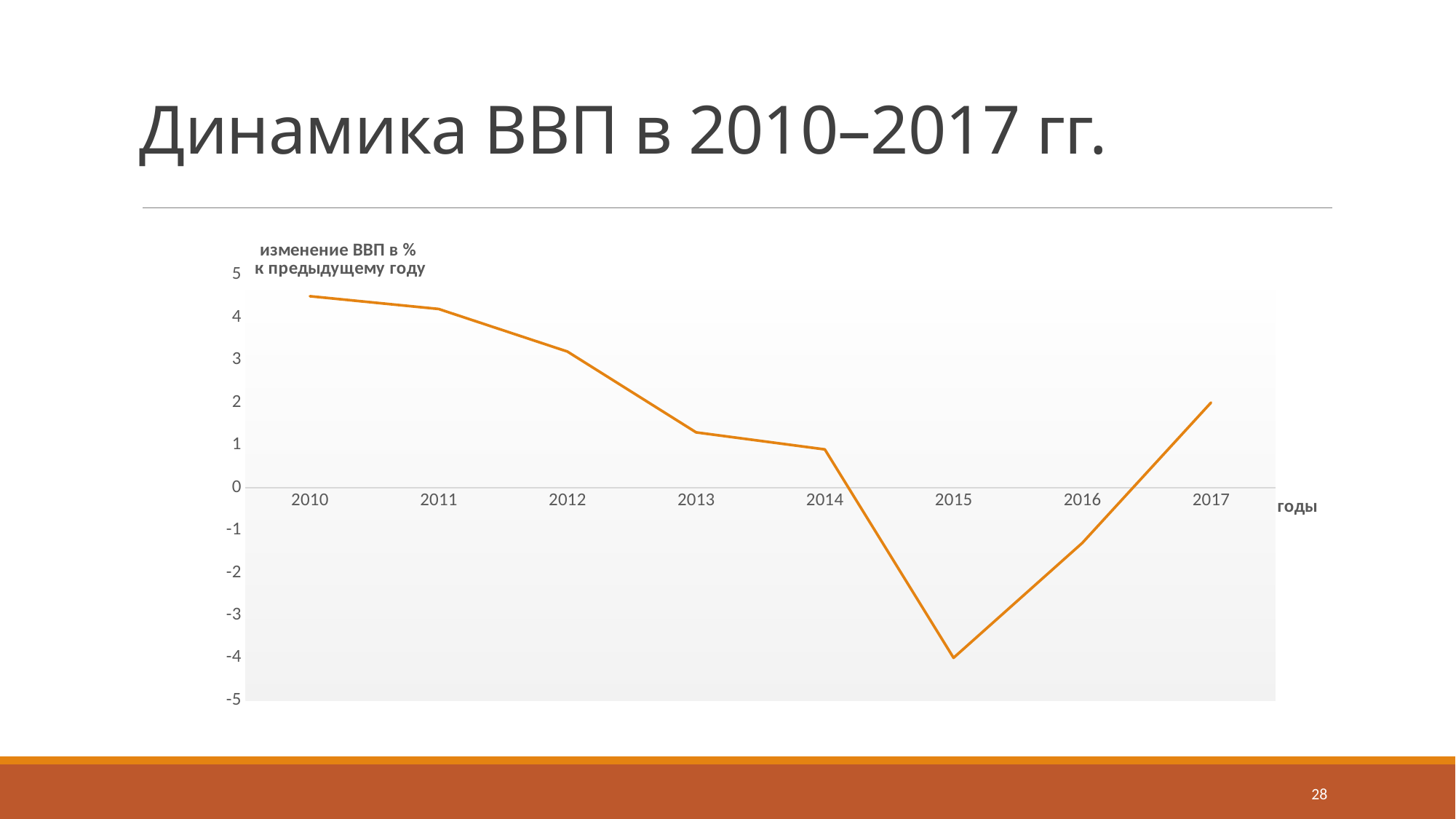
How many years are plotted on the x axis of the chart? 8 Which year has the highest GDP change value in the chart? 2010 Is the value for 2017 greater or less than 1? greater What kind of chart is shown on the slide? line chart Which year has the larger value, 2012 or 2016? 2012 Is the value for 2010 greater or less than 4? greater Is the value for 2015 greater or less than -3? less Which year has the lowest GDP change value in the chart? 2015 Do the values rise or fall from 2010 to 2015? fall What is the label on the x axis of the chart? годы